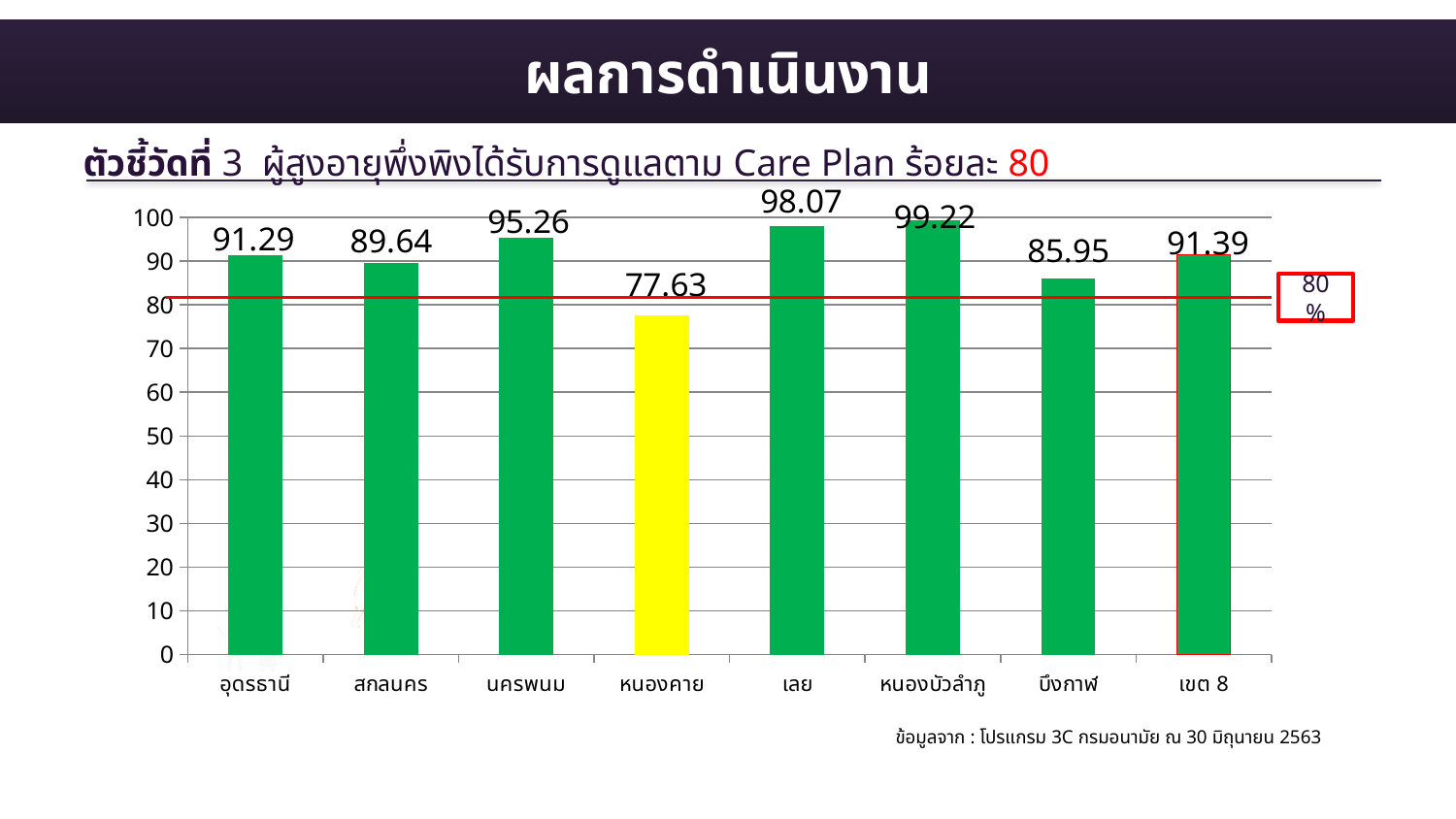
Which category has the highest value? หนองบัวลำภู What is the difference between the values for เลย and บึงกาฬ? 12.12 What target value does the red horizontal line on the chart mark? 80% What is the value for หนองบัวลำภู? 99.22 Which category has the lowest value? หนองคาย What kind of chart is shown on the slide? bar chart Is the value for หนองคาย greater or less than 80? less Which is larger, the value for นครพนม or the value for สกลนคร? นครพนม How many categories are shown on the x axis? 8 Which bar is coloured yellow instead of green? หนองคาย What is the value for หนองคาย? 77.63 What is the value for เขต 8? 91.39